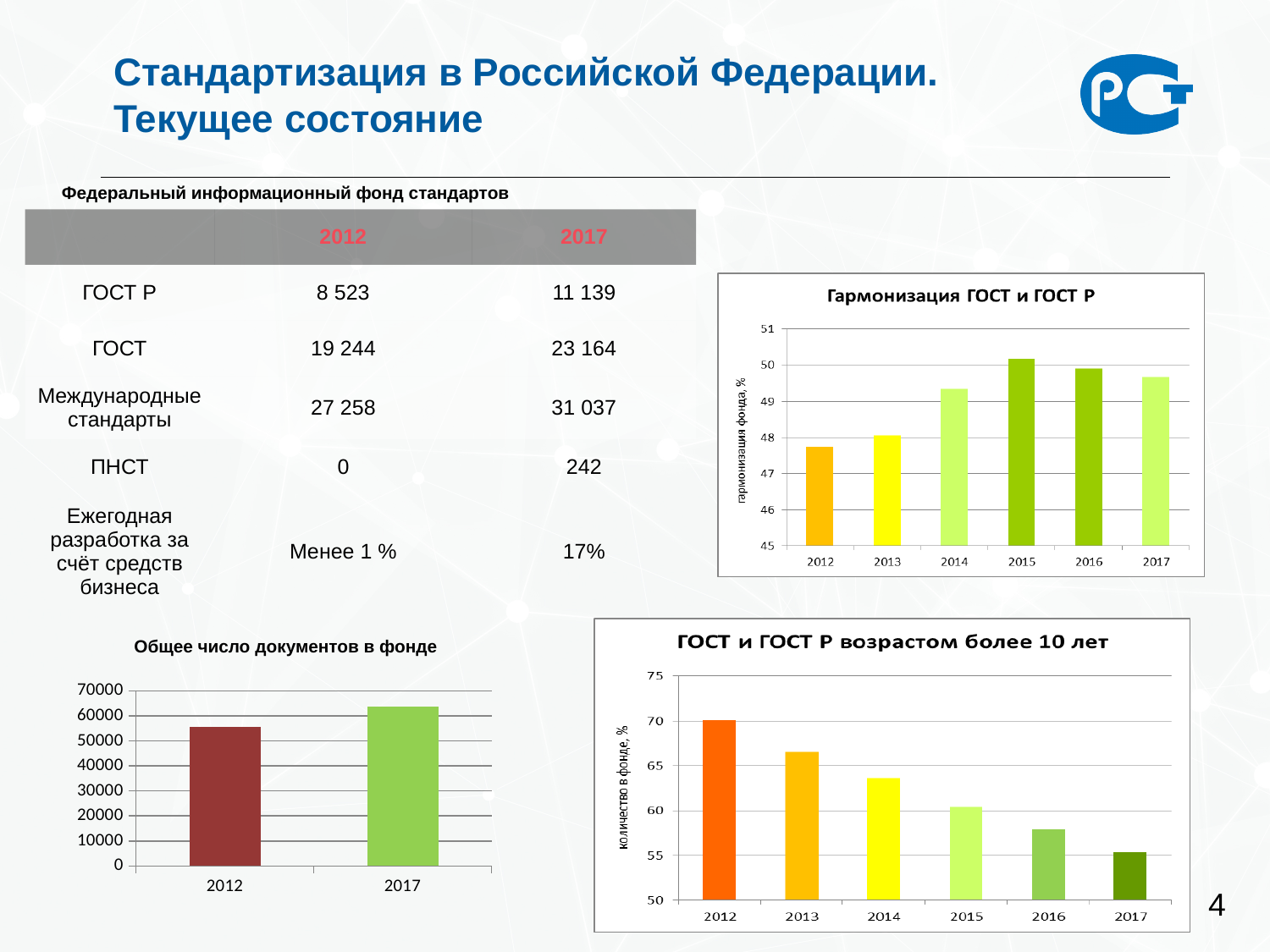
In the chart titled "Гармонизация ГОСТ и ГОСТ Р", is the value for 2015 greater or less than 50? greater In the chart titled "Общее число документов в фонде", is the value for 2017 greater or less than 60000? greater In the chart titled "Общее число документов в фонде", which year has the larger value, 2012 or 2017? 2017 In the chart titled "Гармонизация ГОСТ и ГОСТ Р", which year has the highest value? 2015 In the chart titled "ГОСТ и ГОСТ Р возрастом более 10 лет", do the values rise or fall from 2012 to 2017? fall In the chart titled "ГОСТ и ГОСТ Р возрастом более 10 лет", is the value for 2016 greater or less than 60? less What is the y-axis label of the chart titled "ГОСТ и ГОСТ Р возрастом более 10 лет"? количество в фонде, % In the chart titled "ГОСТ и ГОСТ Р возрастом более 10 лет", which year has the lowest value? 2017 What kind of chart is the chart titled "Общее число документов в фонде"? bar chart How many years are shown on the x axis of the chart titled "Гармонизация ГОСТ и ГОСТ Р"? 6 In the chart titled "Гармонизация ГОСТ и ГОСТ Р", which year has the lowest value? 2012